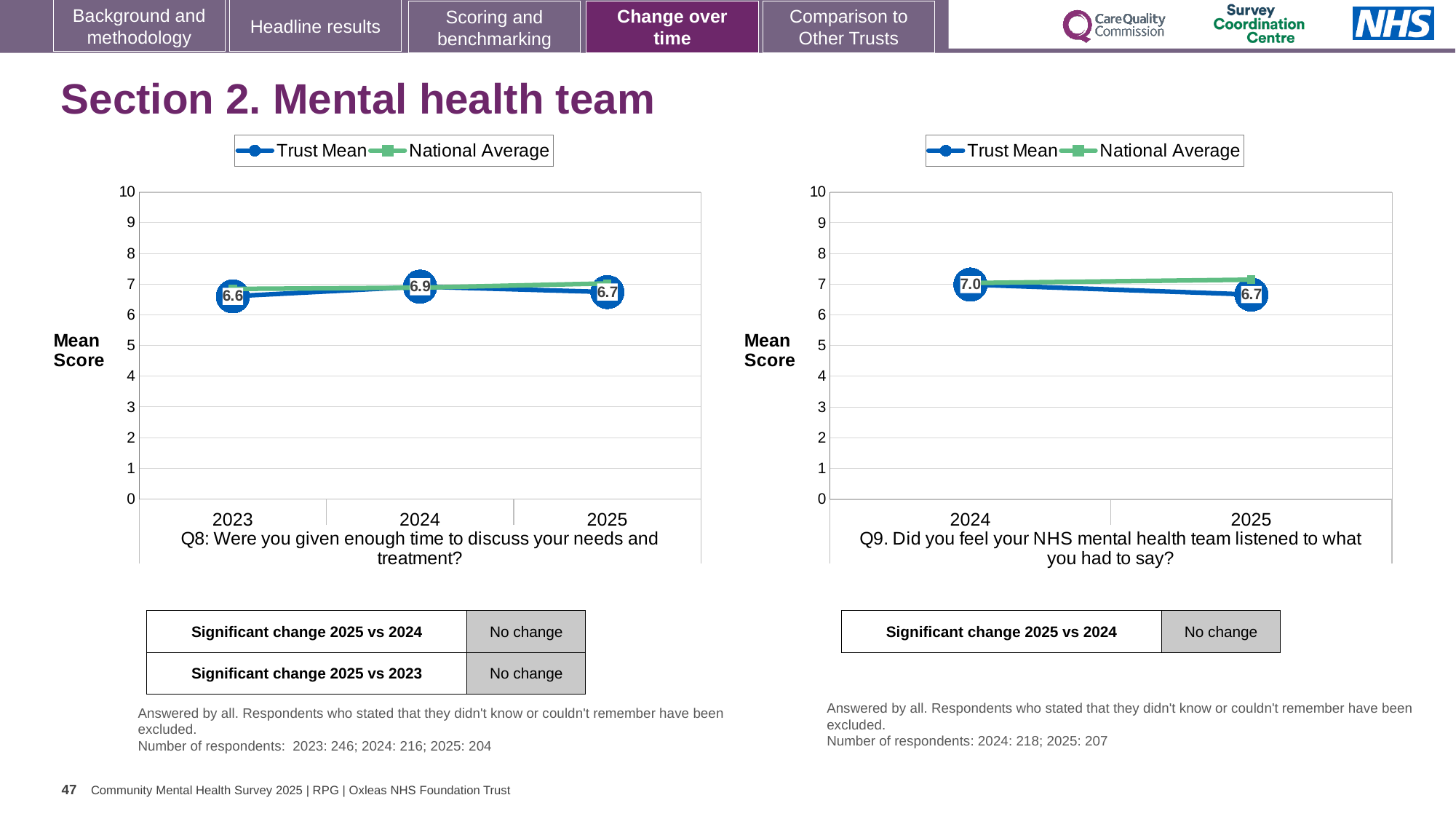
On the Q8 chart (left), which year has the lowest Trust Mean score? 2023 What type of chart is used for Q8 (left)? Line chart On the Q9 chart (right), is the National Average for 2025 greater or less than 5? greater On the Q9 chart (right), what is the Trust Mean score for 2025? 6.7 On the Q9 chart (right), what is the Trust Mean score for 2024? 7.0 On the Q8 chart (left), what is the Trust Mean score for 2024? 6.9 On the Q8 chart (left), is the Trust Mean score higher in 2024 or in 2025? 2024 On the Q8 chart (left), which year has the highest Trust Mean score? 2024 On the Q8 chart (left), what is the Trust Mean score for 2023? 6.6 On the Q9 chart (right), what is the difference between the Trust Mean scores for 2024 and 2025? 0.3 How many series does the legend of the Q9 chart (right) list? 2 How many years are plotted on the Q8 chart (left)? 3